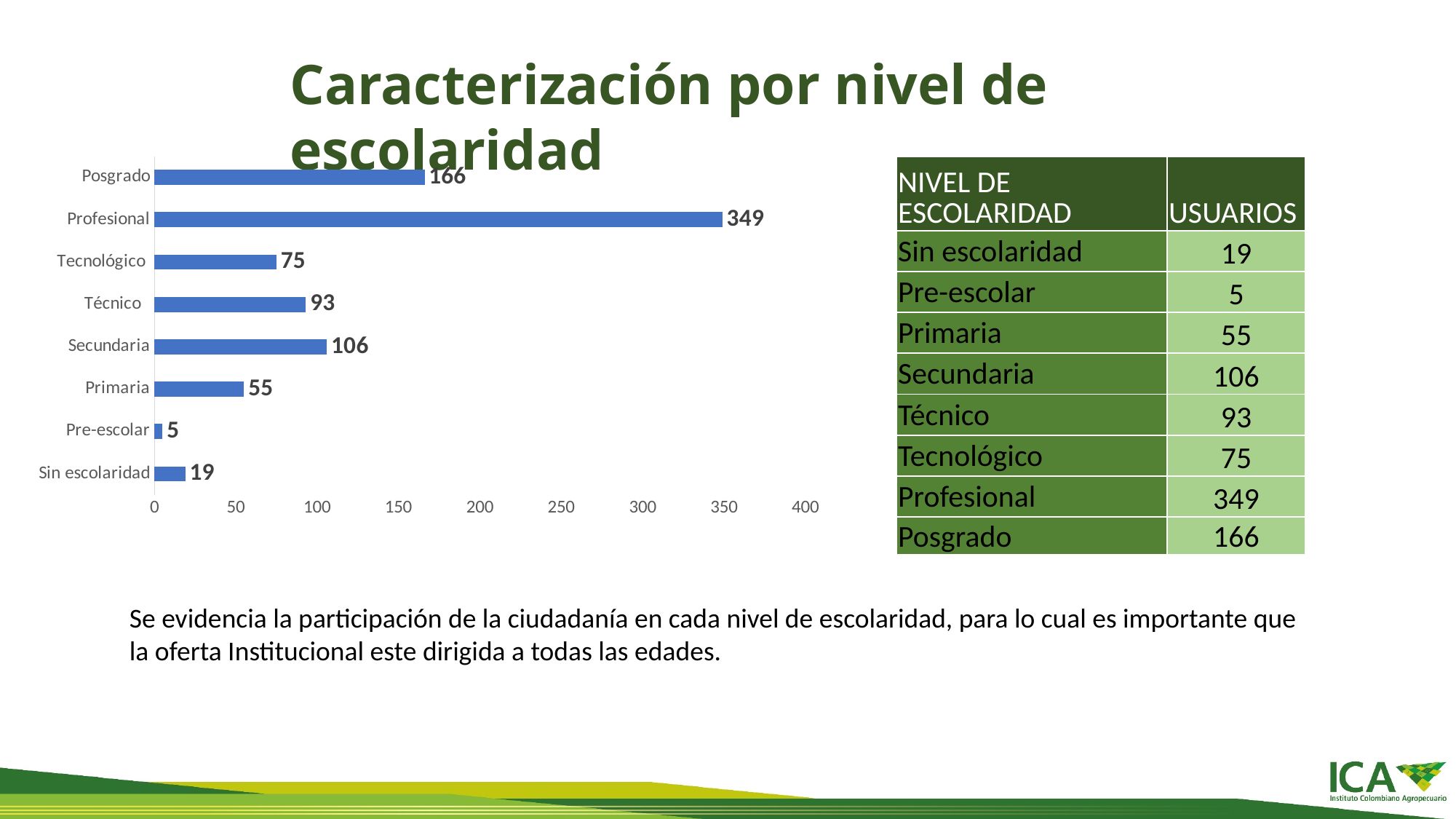
What is the value for Técnico? 93 Which category has the highest value? Profesional What kind of chart is shown on the slide? bar chart What is the difference between the values for Secundaria and Primaria? 51 How many categories are shown in the chart? 8 What is the difference between the values for Profesional and Posgrado? 183 What is the value for Posgrado? 166 What is the value for Profesional? 349 Which category has the lowest value? Pre-escolar Is the value for Secundaria greater or less than 100? greater Which is larger, the value for Técnico or the value for Tecnológico? Técnico What is the title of the slide containing the chart? Caracterización por nivel de escolaridad